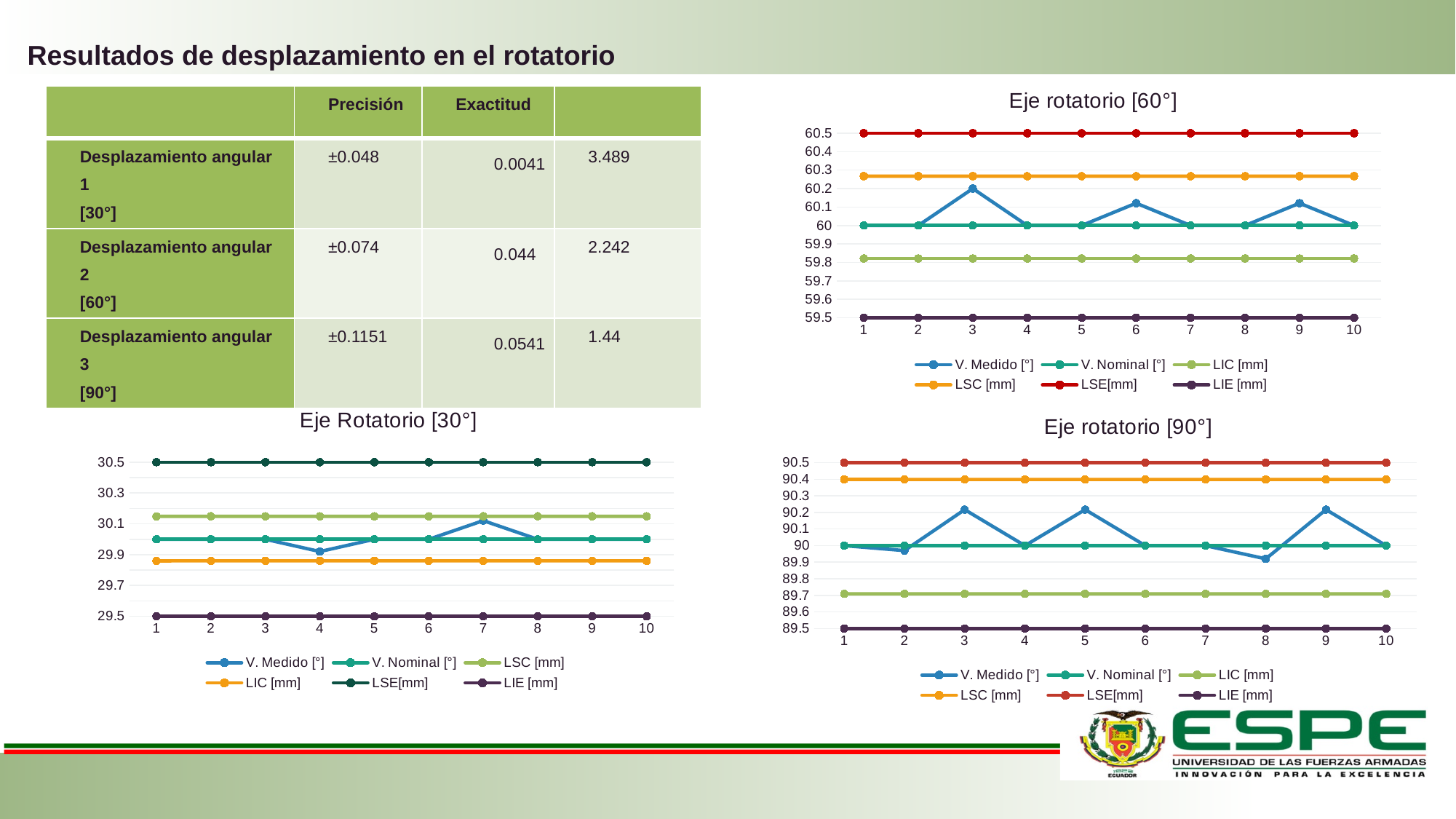
In the 'Eje rotatorio [60°]' chart, is the value of LSC [mm] greater or less than 60.2? greater What kind of chart is the 'Eje rotatorio [60°]' chart? line chart In the 'Eje rotatorio [90°]' chart, what is the value of the LSC [mm] series? 90.4 In the 'Eje Rotatorio [30°]' chart, what is the value of the LSE[mm] series? 30.5 In the 'Eje rotatorio [60°]' chart, how many series does the legend list? 6 In the 'Eje rotatorio [60°]' chart, at which x-axis point does the V. Medido [°] series reach its highest value? 3 In the 'Eje rotatorio [90°]' chart, which series has the larger value, LSE[mm] or LIC [mm]? LSE[mm] In the 'Eje rotatorio [60°]' chart, what is the value of the LIE [mm] series? 59.5 In the 'Eje rotatorio [90°]' chart, is the value of V. Medido [°] at point 8 greater or less than 90? less In the 'Eje rotatorio [60°]' chart, what is the value of the LSE[mm] series? 60.5 In the 'Eje Rotatorio [30°]' chart, how many points are plotted along the x axis for each series? 10 In the 'Eje Rotatorio [30°]' chart, is the value of V. Medido [°] at point 4 greater or less than 30.1? less